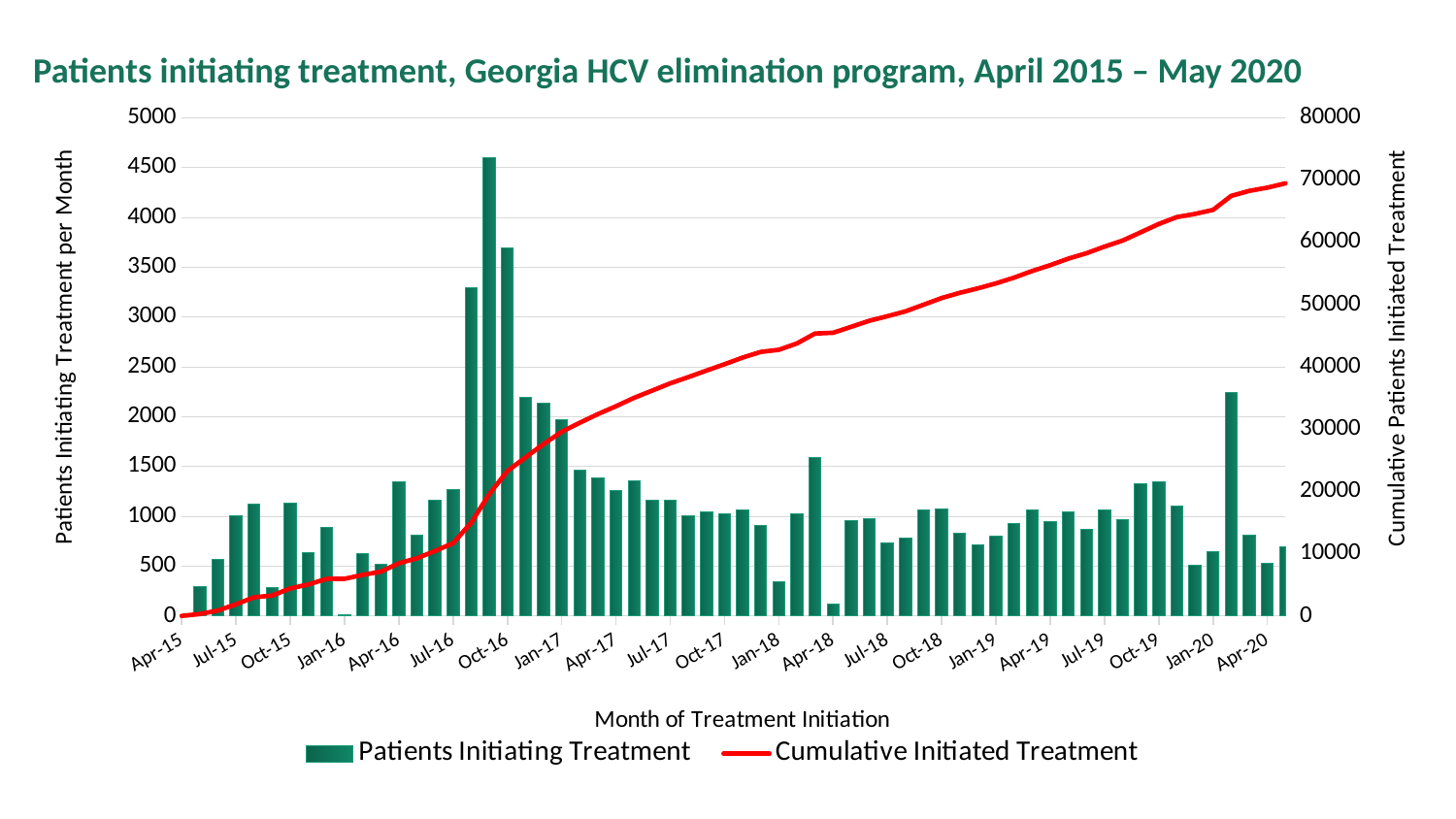
Is the Cumulative Initiated Treatment value at Apr-16 greater or less than 10000? less What is the title of the right-hand vertical axis? Cumulative Patients Initiated Treatment Is the highest monthly value of Patients Initiating Treatment greater or less than 4000? greater Is the value of Patients Initiating Treatment for Apr-15 greater or less than 500? less Does the Cumulative Initiated Treatment line rise or fall from Apr-15 to Apr-20? Rises Which month has the larger value of Patients Initiating Treatment, Oct-16 or Oct-17? Oct-16 How many series does the legend list? 2 What is the title of the chart? Patients initiating treatment, Georgia HCV elimination program, April 2015 – May 2020 What kind of chart is shown on the slide? Combination bar and line chart